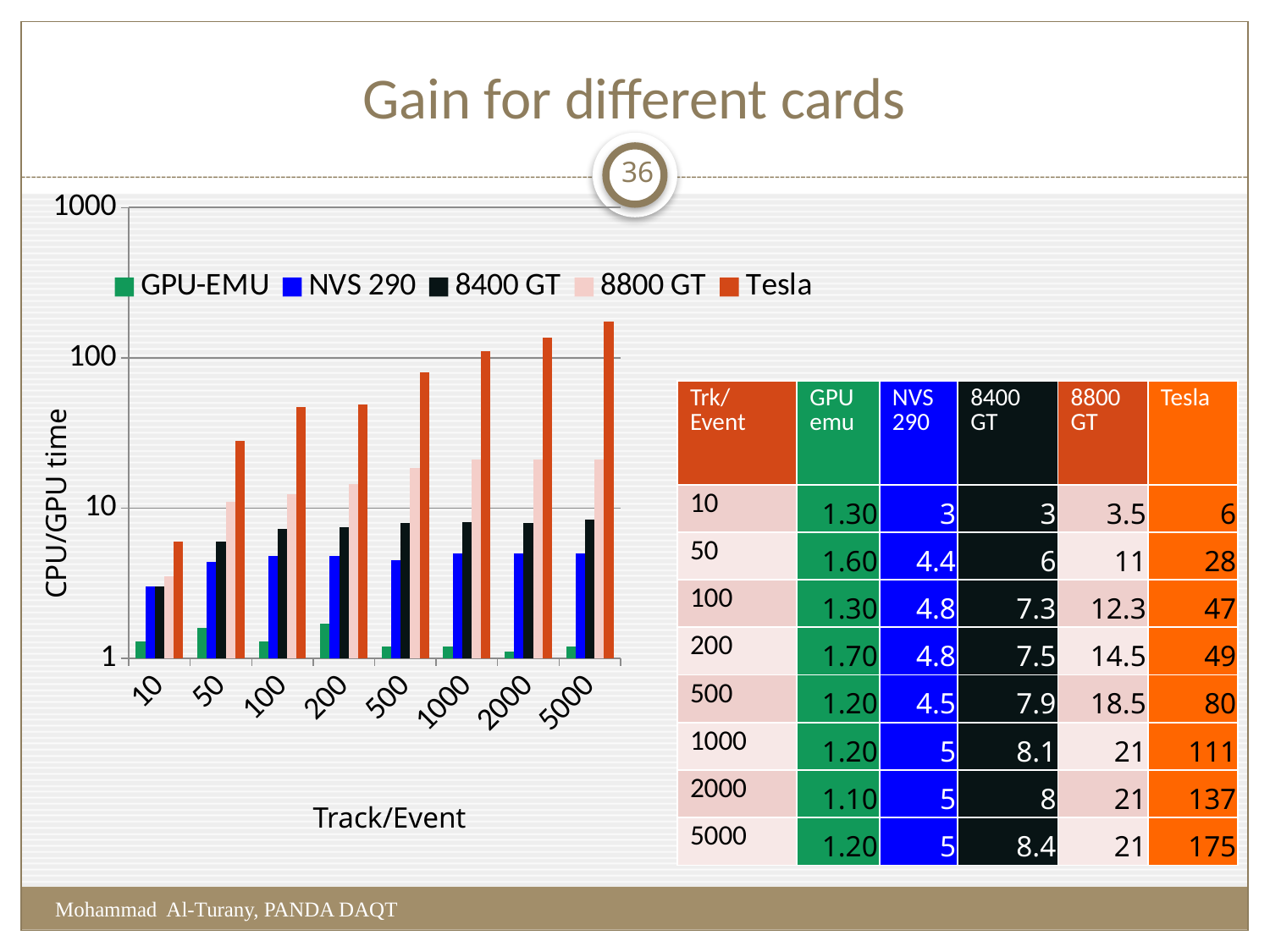
At 100 tracks per event, which is larger: the 8400 GT value or the NVS 290 value? 8400 GT Which series has the lowest value at 1000 tracks per event? GPU-EMU According to the table, what is the NVS 290 value at 50 tracks per event? 4.4 Which card has the highest value at 5000 tracks per event? Tesla Do the Tesla values rise or fall as Track/Event increases along the x axis? rise Is the Tesla value at 1000 tracks per event greater or less than 100? greater According to the table, what is the Tesla value at 5000 tracks per event? 175 According to the table, what is the 8800 GT value at 500 tracks per event? 18.5 What is the difference between the Tesla value and the 8800 GT value at 2000 tracks per event? 116 How many series does the chart legend list? 5 How many Track/Event categories are shown on the x axis of the chart? 8 What kind of chart is shown on the slide? bar chart